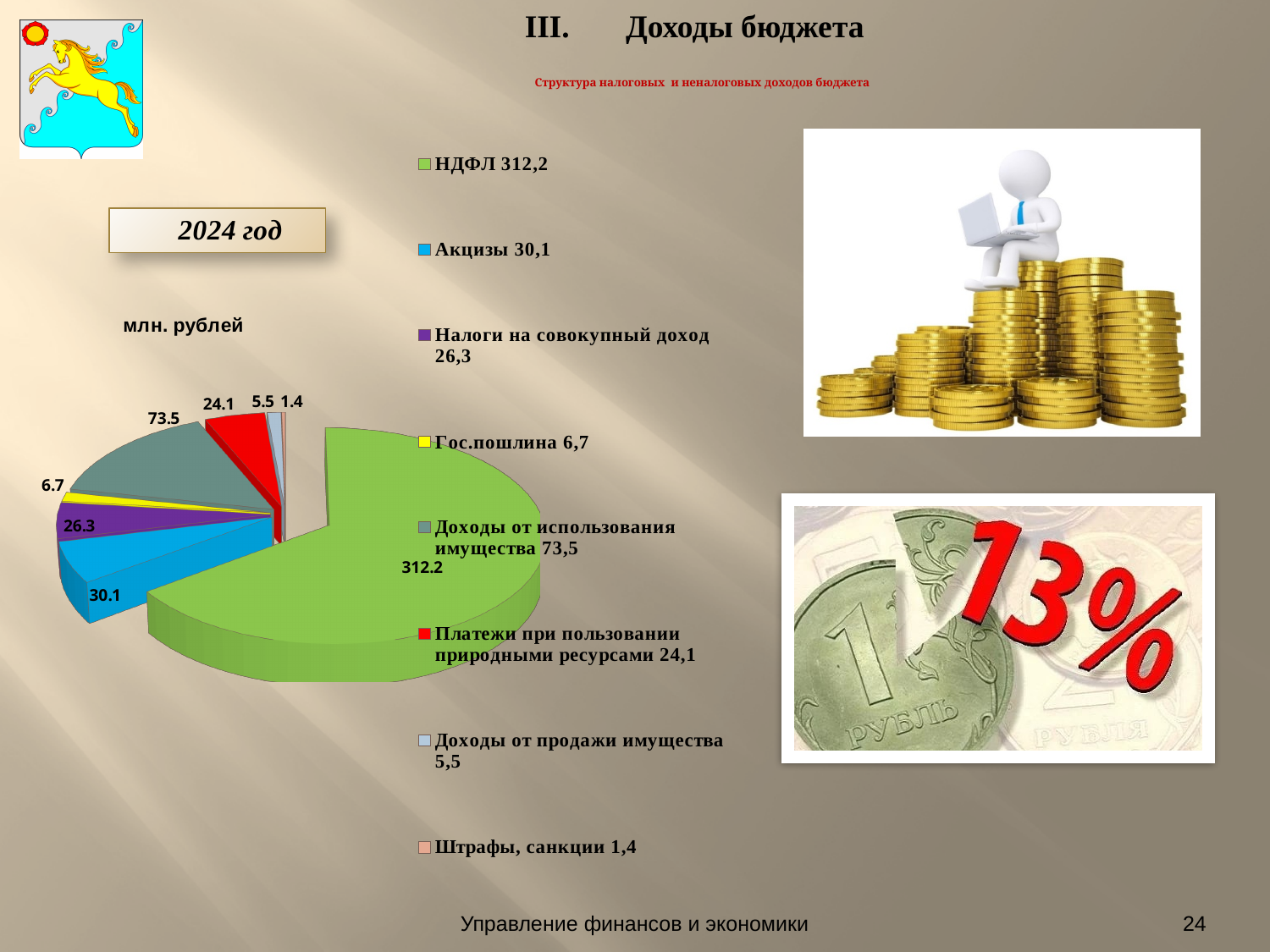
What is the value for Штрафы, санкции? 1.4 What is the value for Доходы от использования имущества? 73.5 Which category has the smallest slice of the pie? Штрафы, санкции How many categories does the pie chart have? 8 What is the value for НДФЛ in the pie chart? 312.2 What unit is stated for the values in the pie chart? млн. рублей What is the difference between НДФЛ and Доходы от использования имущества? 238.7 What kind of chart is shown on the slide? Pie chart Which category has the largest slice of the pie? НДФЛ What is the value for Акцизы? 30.1 Which is larger, Акцизы or Налоги на совокупный доход? Акцизы What is the difference between Доходы от использования имущества and Акцизы? 43.4